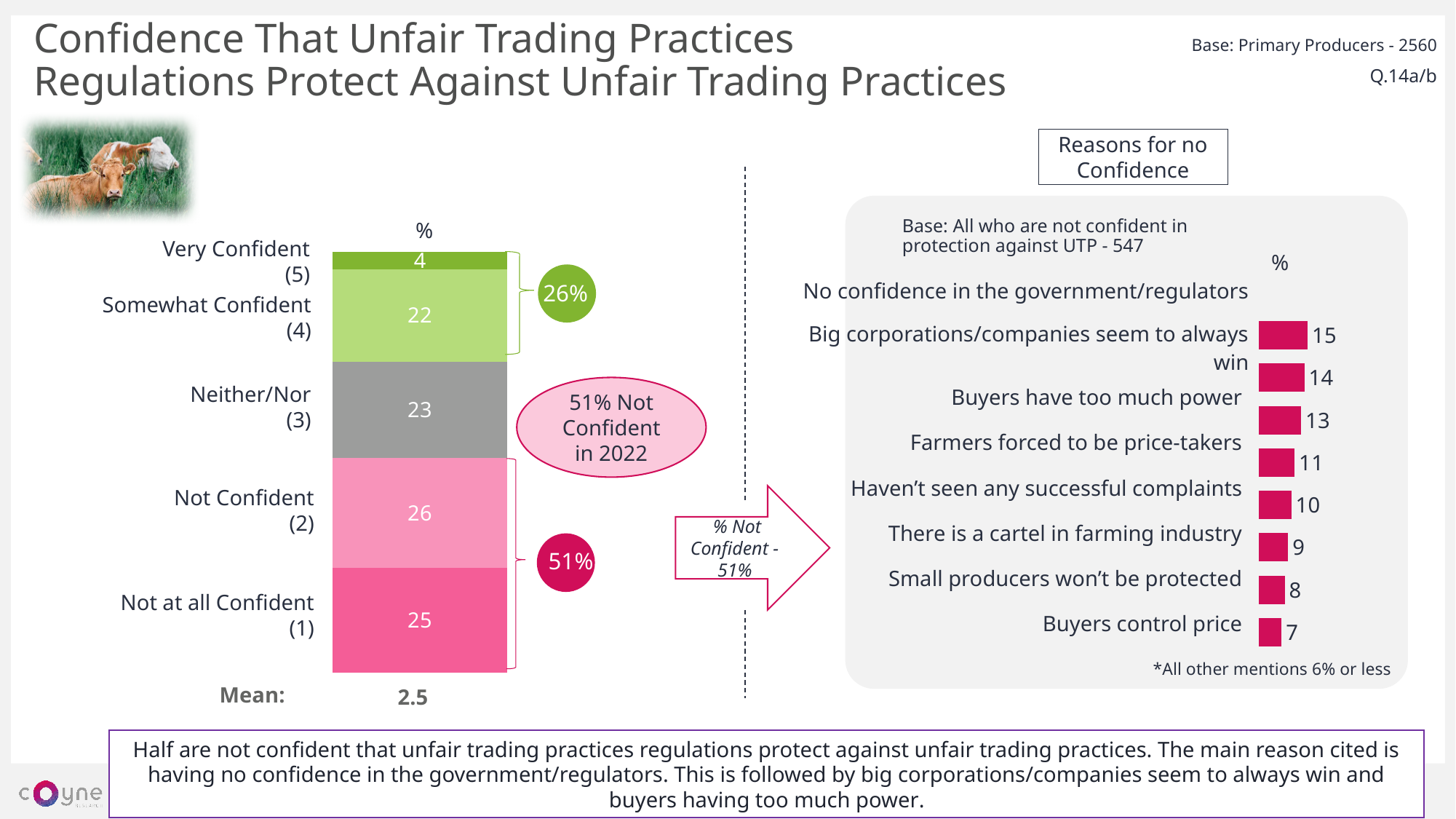
On the Reasons for no Confidence chart, what percentage cited that buyers control price? 7 What is the mean score shown below the left stacked bar chart? 2.5 On the left stacked bar chart, what is the difference between the Neither/Nor (3) share and the Very Confident (5) share? 19 On the left stacked bar chart, what percentage are Somewhat Confident (4)? 22 On the left stacked bar chart, what percentage of primary producers are Very Confident (5)? 4 On the left stacked bar chart, which confidence level has the smallest share? Very Confident (5) On the Reasons for no Confidence chart, what percentage cited no confidence in the government/regulators? 15 On the left stacked bar chart, what is the combined percentage of Not Confident (2) and Not at all Confident (1)? 51% On the left stacked bar chart, which confidence level has the largest share? Not Confident (2) What type of chart is the Reasons for no Confidence chart? Bar chart On the left stacked bar chart, what percentage are Not Confident (2)? 26 How many reasons are listed on the Reasons for no Confidence chart? 8